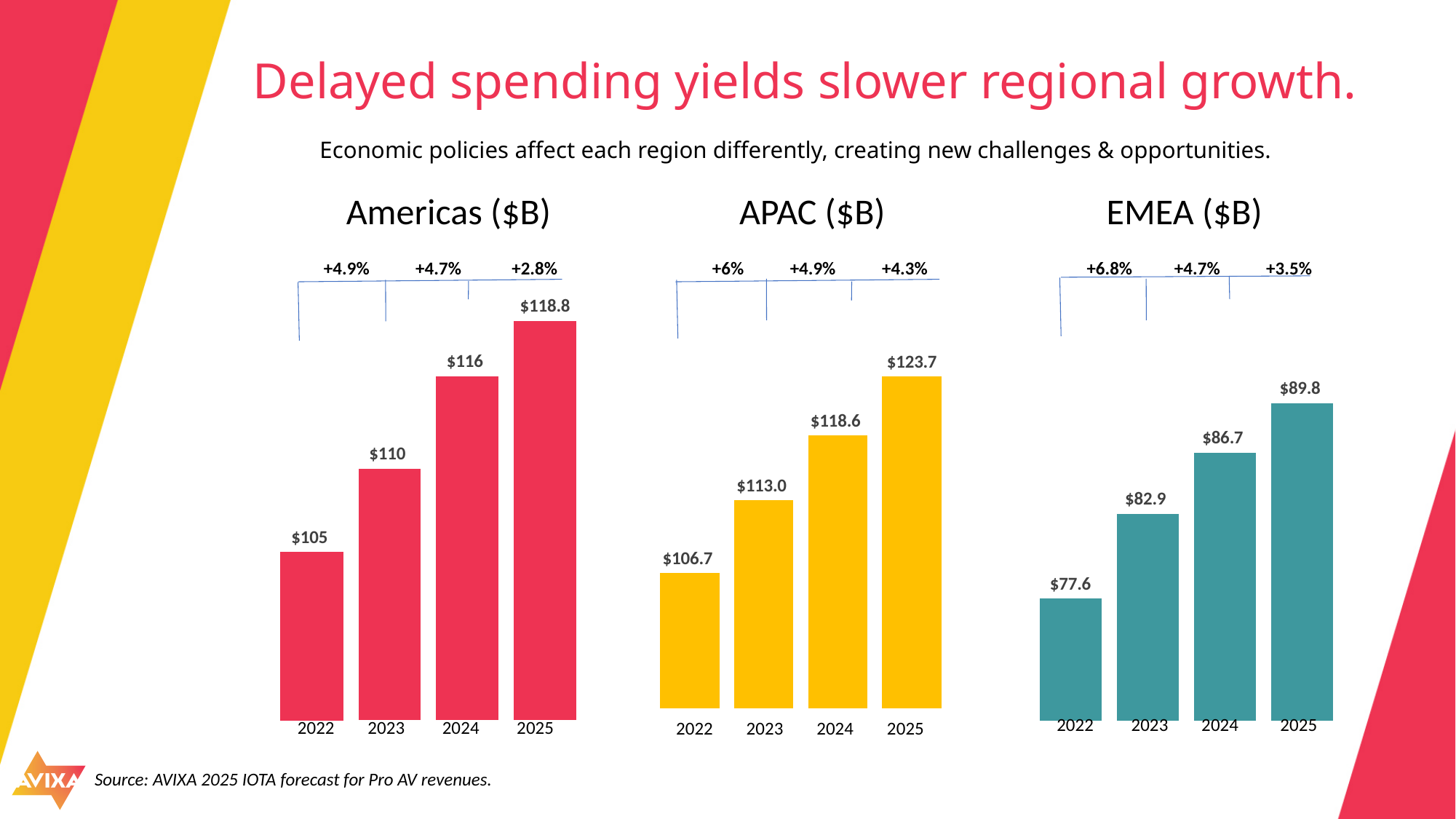
In the EMEA ($B) chart, do the values rise or fall from 2022 to 2025? Rise In the APAC ($B) chart, which year has the lowest value? 2022 What kind of chart is the Americas ($B) chart? Bar chart In the APAC ($B) chart, what is the value for 2023? $113.0 In the EMEA ($B) chart, which year has the highest value? 2025 How many bars are in the EMEA ($B) chart? 4 In the APAC ($B) chart, what is the difference between the 2024 and 2023 values? $5.6 In the EMEA ($B) chart, what is the value for 2022? $77.6 What colour are the bars in the APAC ($B) chart? Yellow In the Americas ($B) chart, what is the difference between the 2025 and 2022 values? $13.8 In the Americas ($B) chart, what is the value for 2025? $118.8 Which is larger: the 2025 value in the APAC ($B) chart or the 2025 value in the Americas ($B) chart? APAC